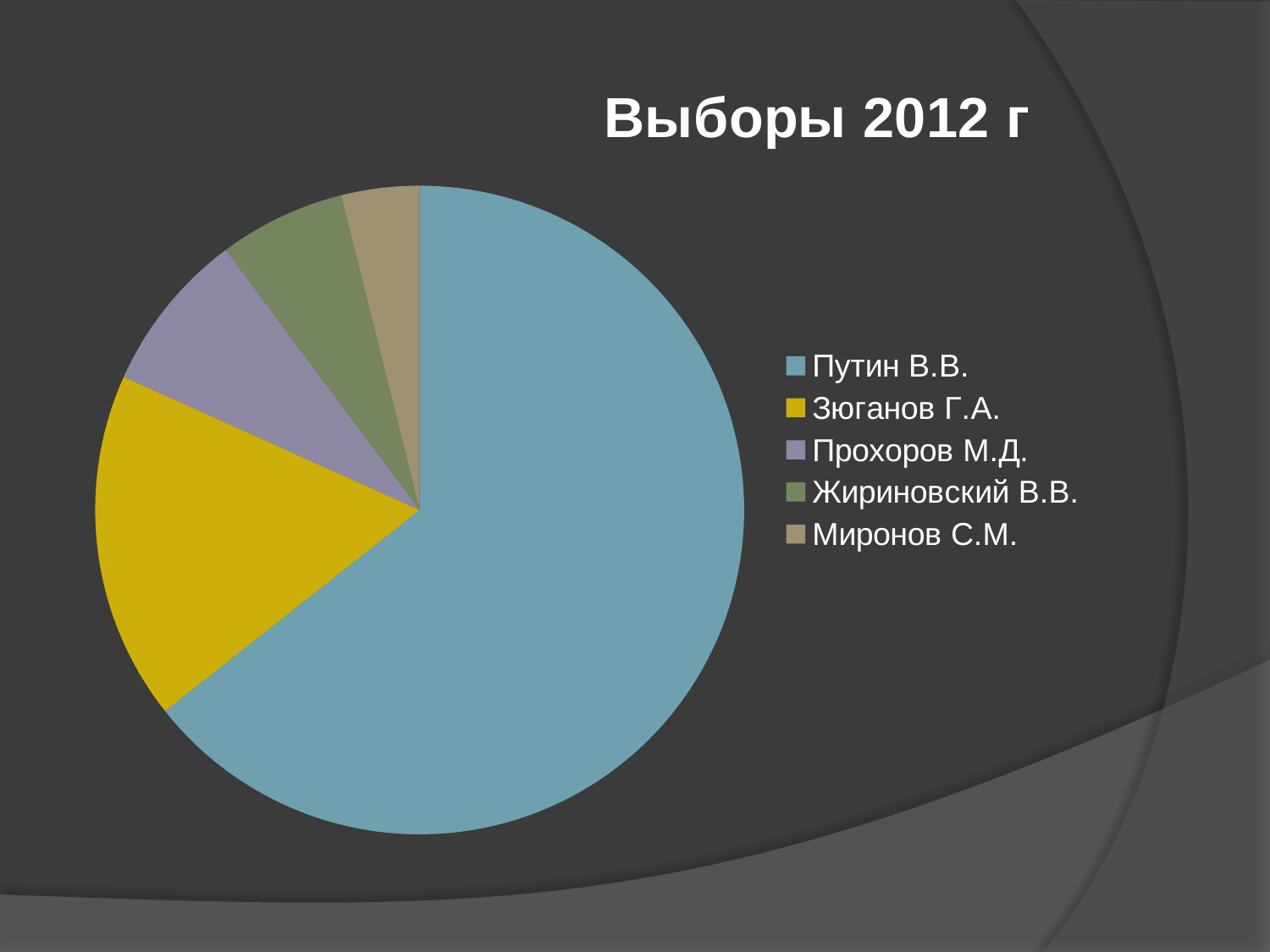
Which candidate has the smallest slice of the pie? Миронов С.М. Does the slice for Путин В.В. take up more or less than half of the pie? more Which slice is larger, Путин В.В. or Зюганов Г.А.? Путин В.В. Which candidate has the second-largest slice of the pie? Зюганов Г.А. What kind of chart is shown on the slide? pie chart What colour is the slice for Зюганов Г.А.? yellow Which slice is larger, Зюганов Г.А. or Прохоров М.Д.? Зюганов Г.А. Which candidate has the largest slice of the pie? Путин В.В. How many entries does the legend list? 5 What is the title of the chart? Выборы 2012 г How many slices does the pie chart have? 5